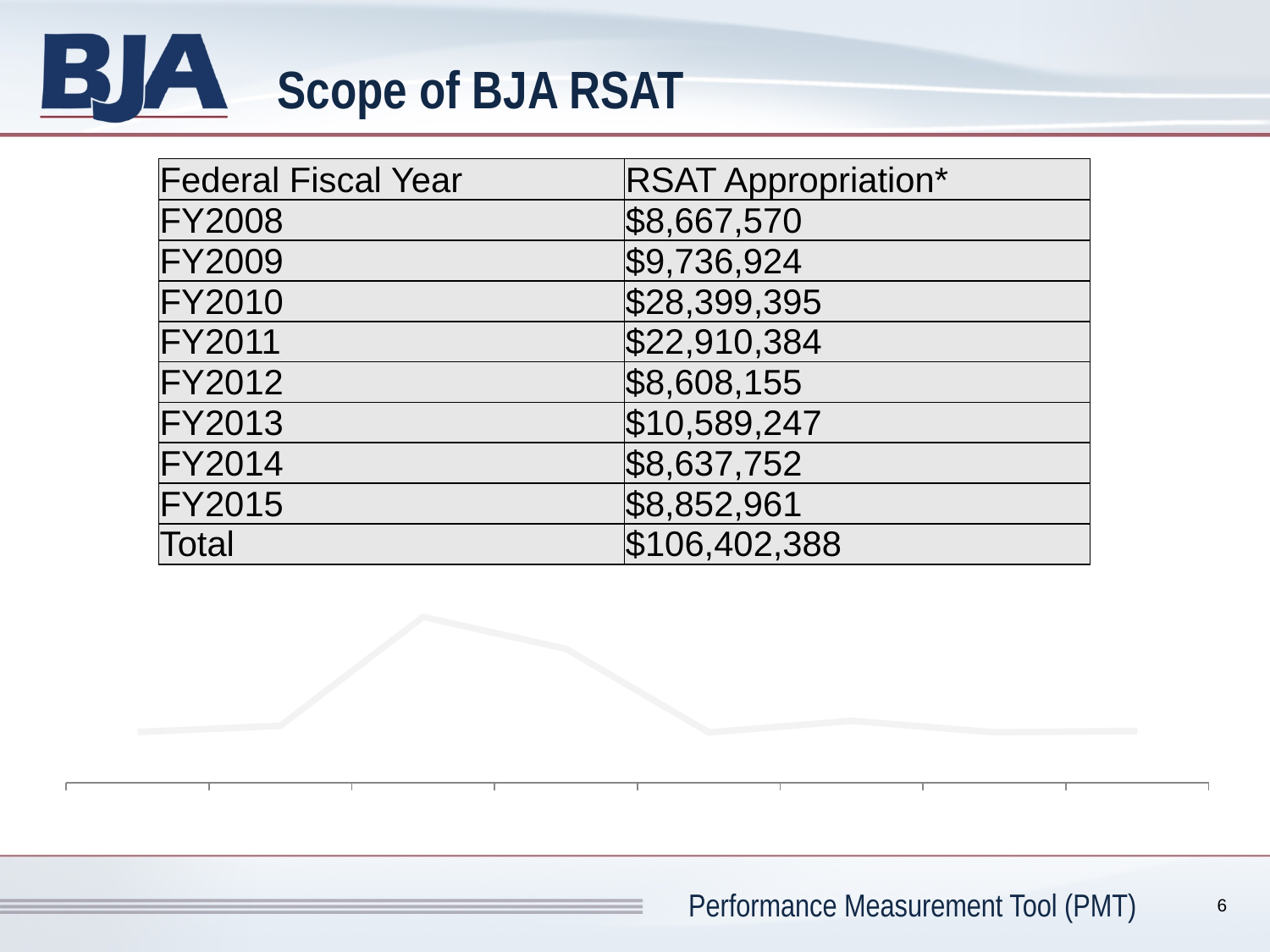
In the line chart below the table, does the line rise or fall between the second and third points from the left? rise Does the line chart below the table show any data labels or axis labels? No How many data points does the line in the chart below the table have? 8 Does the line chart below the table show a legend? No What kind of chart is shown below the table on the slide? line chart In the line chart below the table, which point from the left is the highest? the third point In the line chart below the table, is the third point from the left higher or lower than the last point? higher In the line chart below the table, does the line rise or fall between the third and fifth points from the left? fall